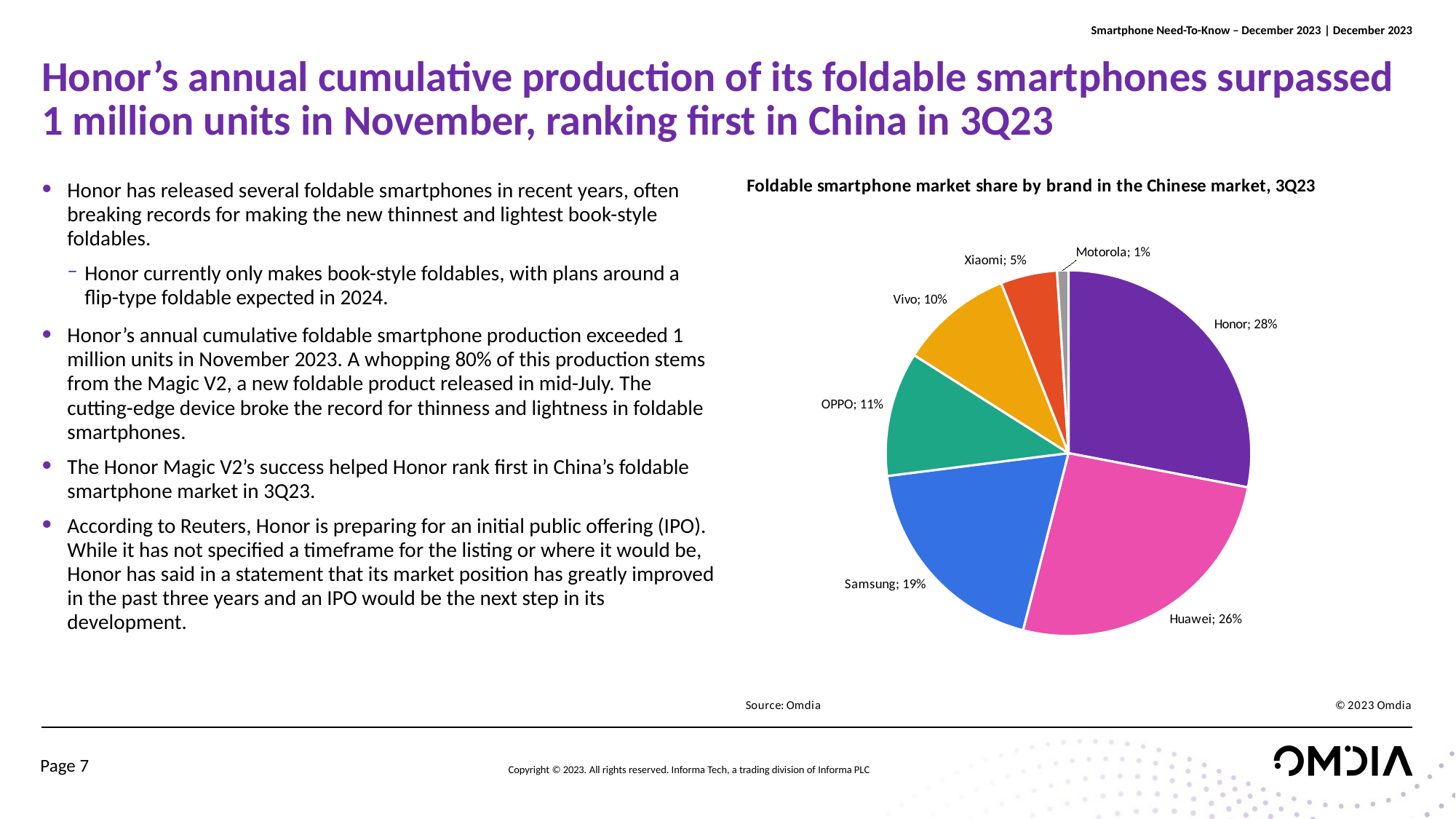
What is the title of the chart? Foldable smartphone market share by brand in the Chinese market, 3Q23 What is Honor's share of the foldable smartphone market in China in 3Q23? 28% What is Huawei's market share shown in the pie chart? 26% What type of chart is shown on the slide? pie chart How many brands are shown in the pie chart? 7 What is Samsung's market share shown in the pie chart? 19% What is OPPO's market share shown in the pie chart? 11% What is the difference between Honor's and Samsung's market shares? 9% Which brand has the largest share in the pie chart? Honor Which brand has the smallest share in the pie chart? Motorola What is the combined share of Honor and Huawei? 54% Which has a larger share, Vivo or Xiaomi? Vivo